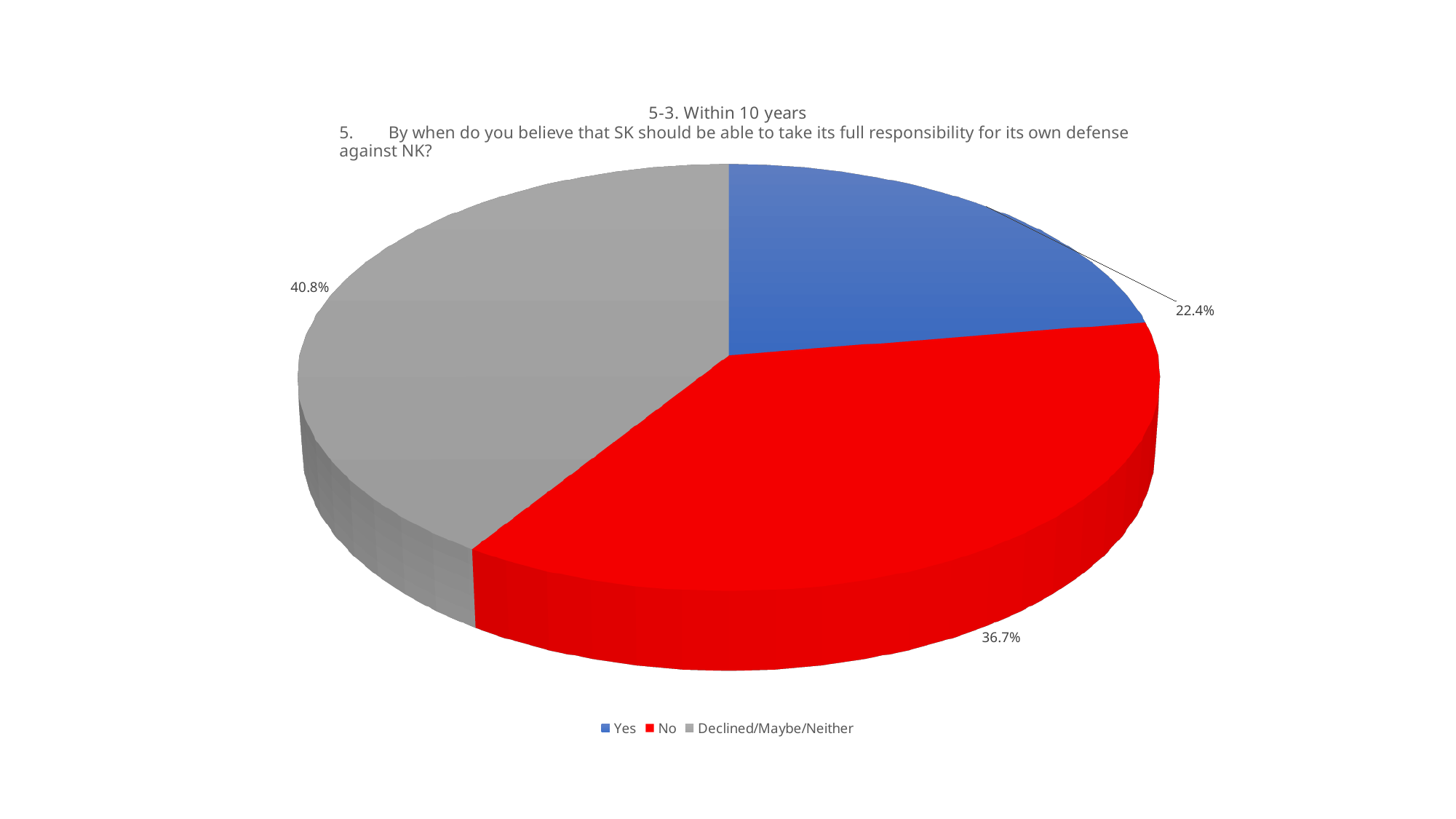
Which category has the smallest share of the pie? Yes What percentage of respondents answered No? 36.7% What percentage of respondents answered Yes? 22.4% What colour is the No slice? Red Which is larger, the share for No or the share for Yes? No What is the difference in percentage points between the Declined/Maybe/Neither and No slices? 4.1 Which category has the largest share of the pie? Declined/Maybe/Neither What is the difference in percentage points between the No and Yes slices? 14.3 How many slices does the pie chart have? 3 What kind of chart is shown on the slide? Pie chart What is the title of the chart? 5-3. Within 10 years What percentage of respondents fall under Declined/Maybe/Neither? 40.8%